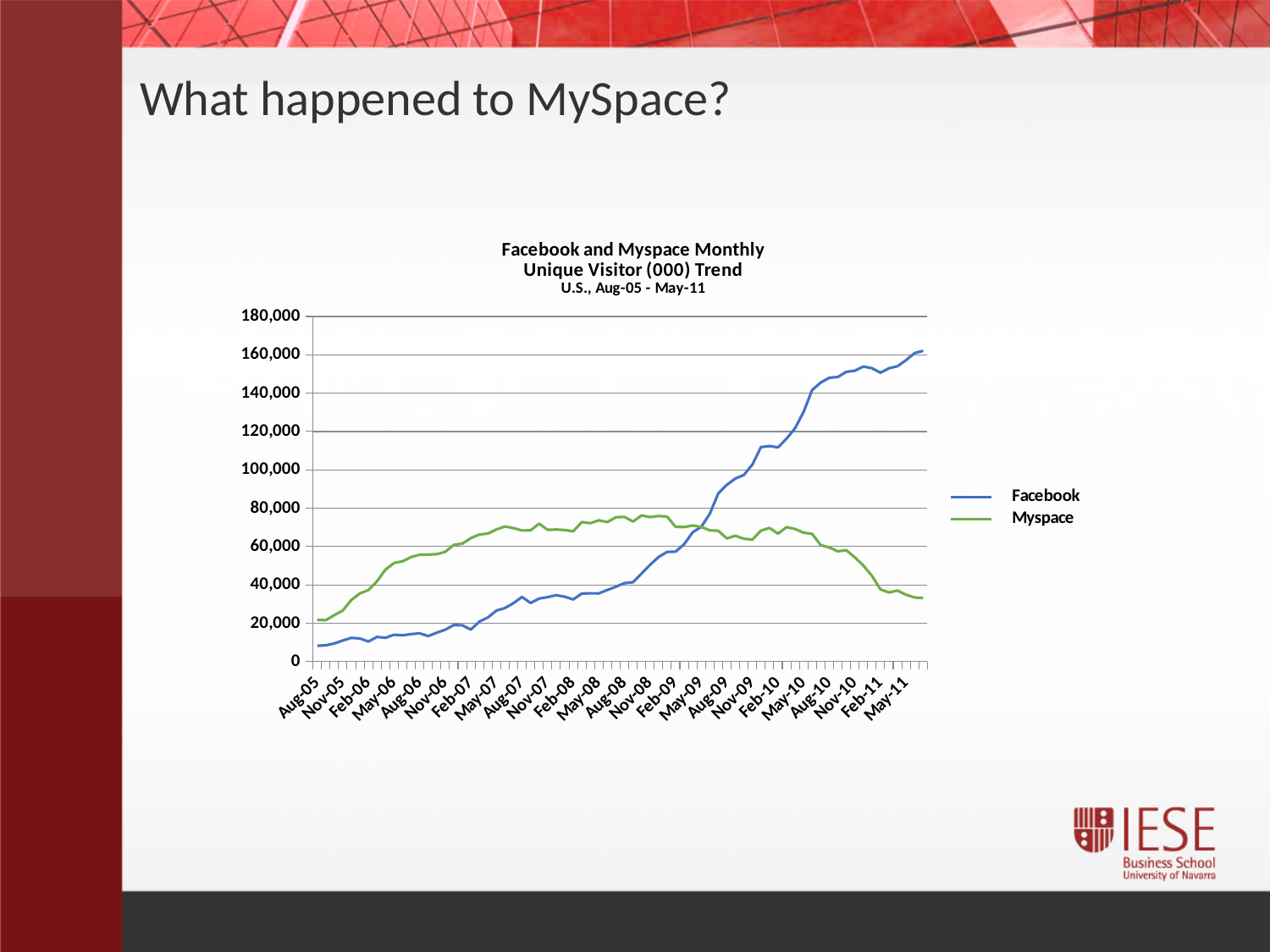
What is the title of the chart? Facebook and Myspace Monthly Unique Visitor (000) Trend U.S., Aug-05 - May-11 At May-11, which series has the higher value, Facebook or Myspace? Facebook What kind of chart is shown on the slide? line chart Which series is drawn in green? Myspace Does the Facebook line generally rise or fall from Aug-05 to May-11? rise Is the value for Myspace at May-11 greater or less than 40,000? less Is the value for Myspace at Aug-08 greater or less than 60,000? greater At Aug-05, which series has the higher value, Facebook or Myspace? Myspace Does the Myspace line rise or fall between Aug-10 and May-11? fall Is the value for Facebook at Aug-05 greater or less than 20,000? less How many series does the legend list? 2